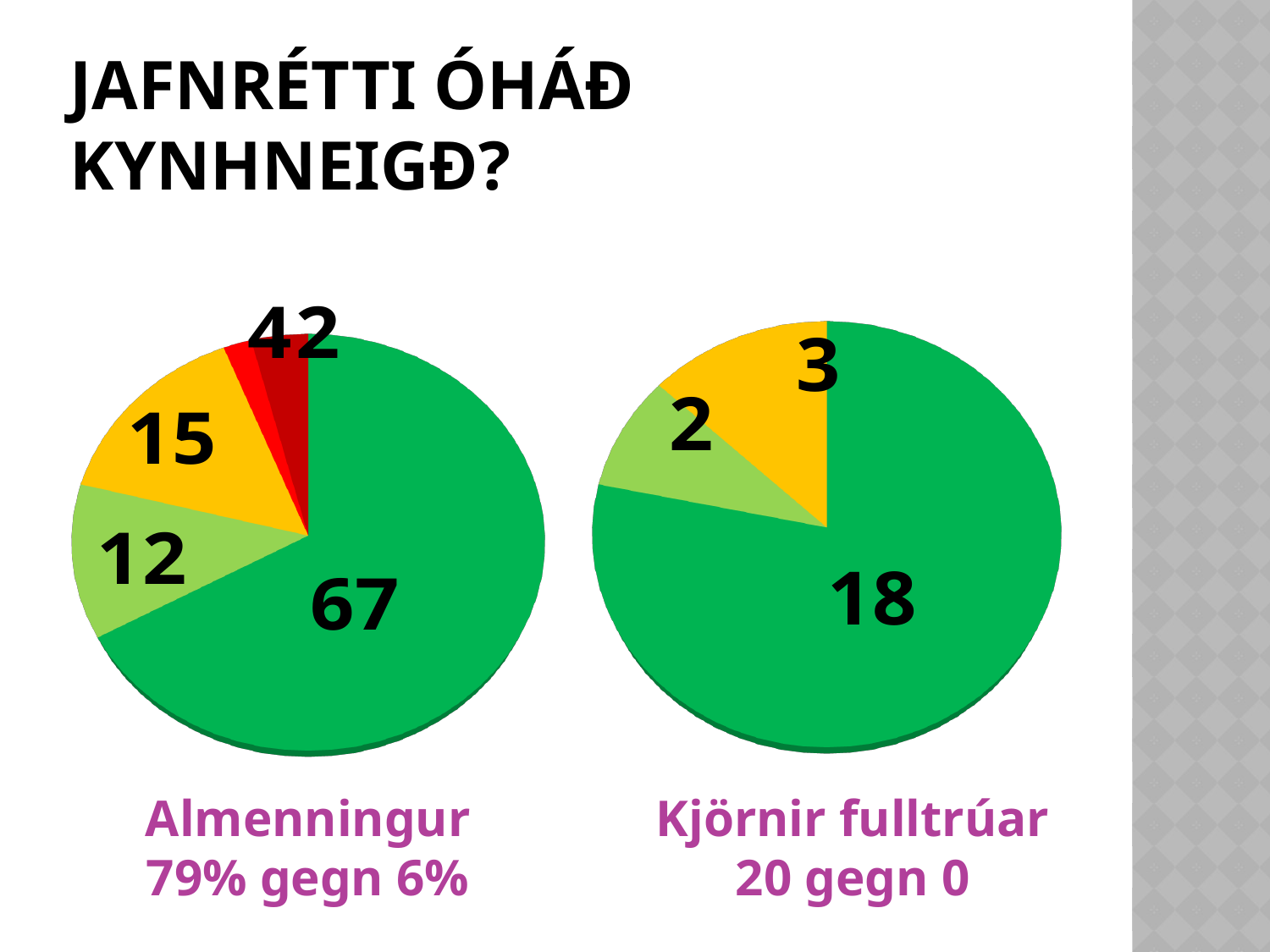
In the Kjörnir fulltrúar pie chart, how many slices are there? 3 In the Kjörnir fulltrúar pie chart, what is the value of the light green slice? 2 In the Almenningur pie chart, what is the value of the yellow slice? 15 How many pie charts are on the slide? 2 In the Almenningur pie chart, what is the difference between the yellow slice and the light green slice? 3 In the Kjörnir fulltrúar pie chart, which is larger, the yellow slice or the light green slice? The yellow slice What kind of charts are shown on the slide? Pie charts In the Almenningur pie chart, what is the value of the largest (dark green) slice? 67 In the Kjörnir fulltrúar pie chart, what is the value of the yellow slice? 3 What is the label under the left pie chart? Almenningur 79% gegn 6% In the Almenningur pie chart, what is the value of the light green slice? 12 In the Kjörnir fulltrúar pie chart, what is the value of the largest (dark green) slice? 18